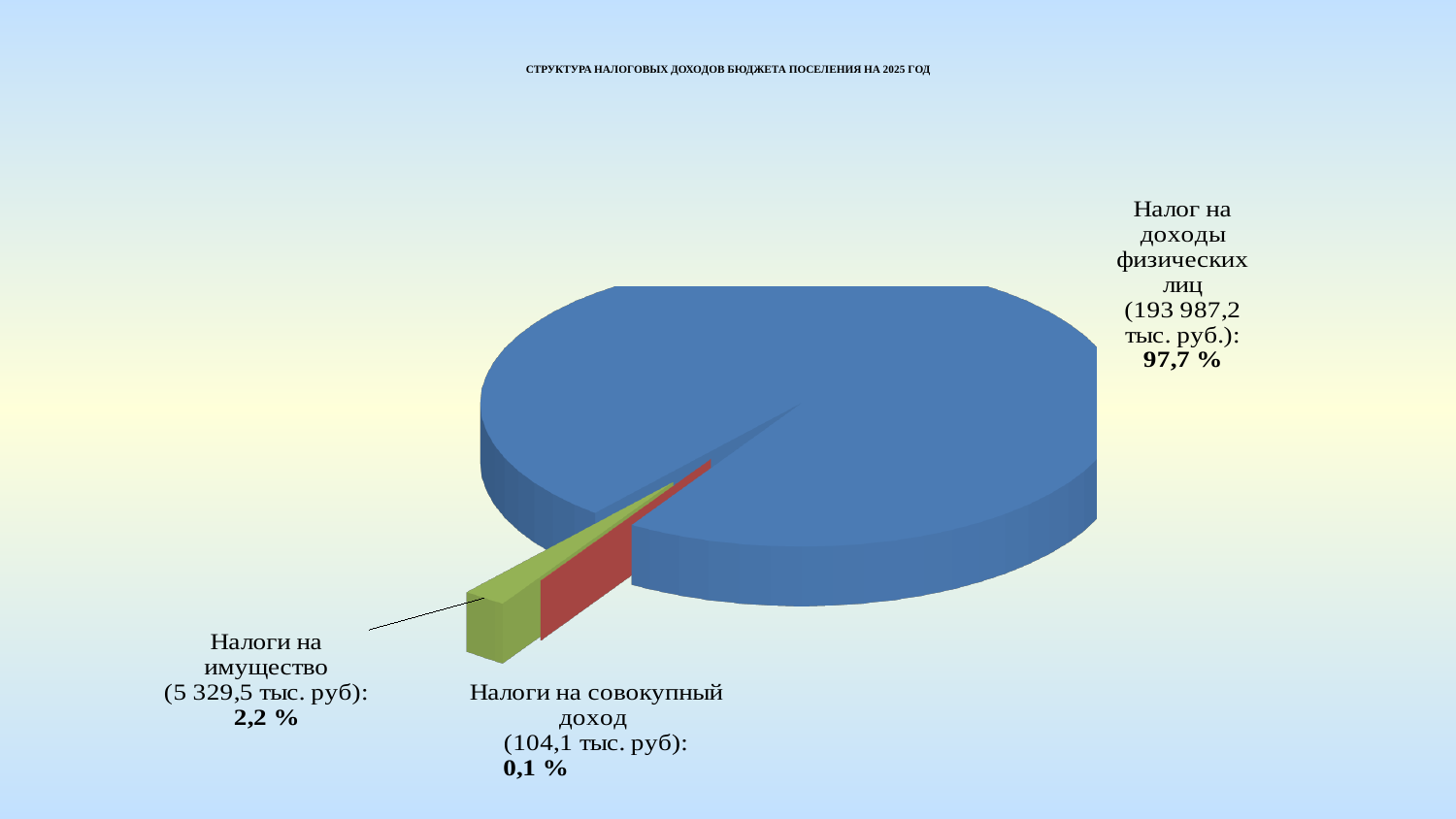
What kind of chart is shown on the slide? Pie chart What share of the pie does 'Налог на доходы физических лиц' take? 97,7 % What share of the pie does 'Налоги на имущество' take? 2,2 % What is the value shown for 'Налог на доходы физических лиц'? 193 987,2 тыс. руб. Which category has the smallest slice of the pie? Налоги на совокупный доход What is the value shown for 'Налоги на совокупный доход'? 104,1 тыс. руб What is the value shown for 'Налоги на имущество'? 5 329,5 тыс. руб What is the title of the chart? СТРУКТУРА НАЛОГОВЫХ ДОХОДОВ БЮДЖЕТА ПОСЕЛЕНИЯ НА 2025 ГОД Which category has the largest slice of the pie? Налог на доходы физических лиц Which is larger: 'Налоги на имущество' or 'Налоги на совокупный доход'? Налоги на имущество What share of the pie does 'Налоги на совокупный доход' take? 0,1 % How many slices does the pie chart have? 3